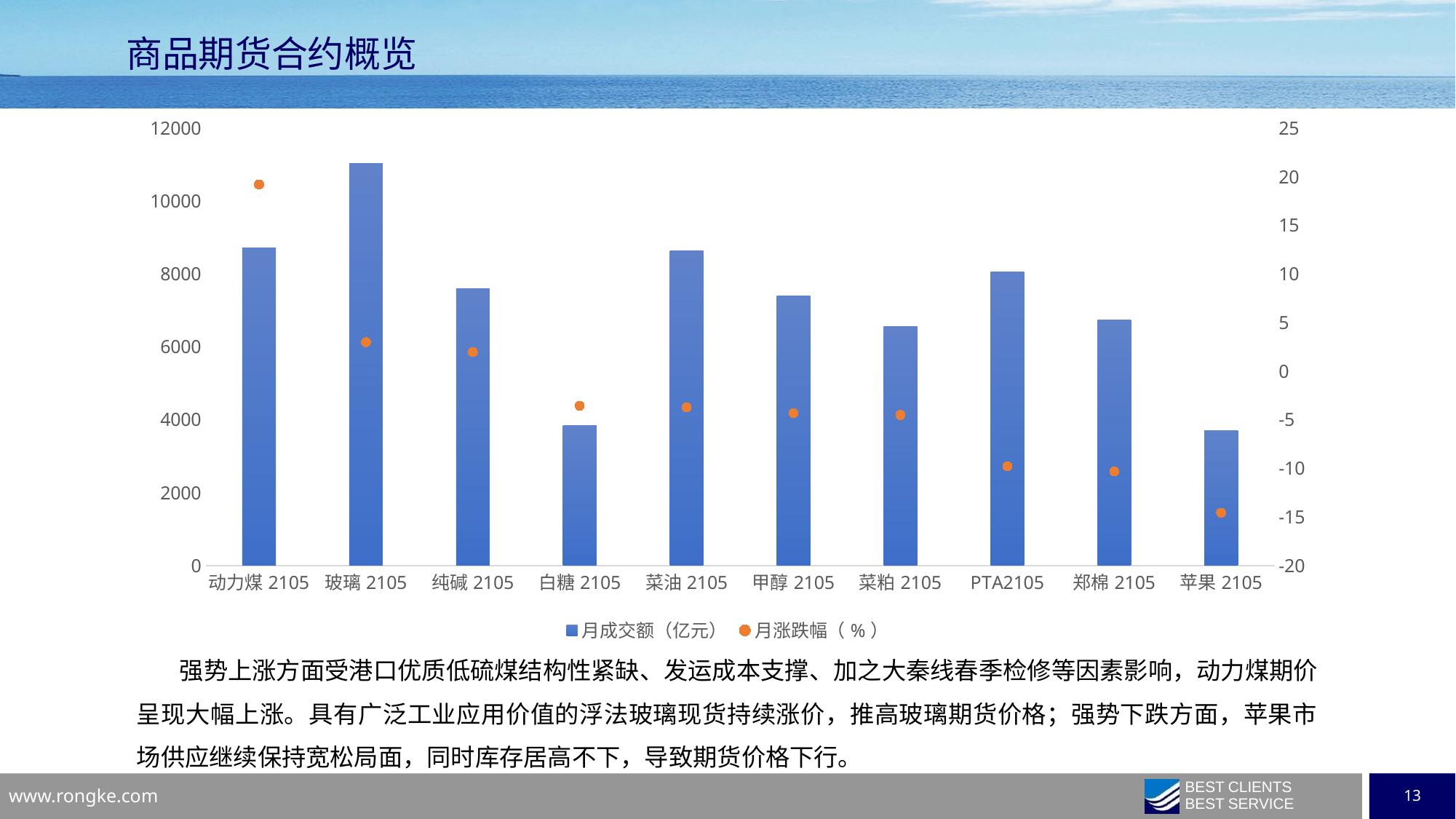
What kind of chart is shown on the slide? Bar chart with dot markers (combo chart) Which contract has the highest 月涨跌幅（%） marker? 动力煤 2105 Is the 月涨跌幅（%） marker for 动力煤 2105 greater or less than 15? greater Is the 月成交额（亿元） bar for 玻璃 2105 greater or less than 10000? greater Is the 月成交额（亿元） bar for 白糖 2105 greater or less than 4000? less Which has the larger 月成交额（亿元） bar, 动力煤 2105 or 纯碱 2105? 动力煤 2105 Which contract has the lowest 月涨跌幅（%） marker? 苹果 2105 What is the title of the chart on the slide? 商品期货合约概览 Which contract has the highest 月成交额（亿元） bar? 玻璃 2105 What are the two series named in the chart legend? 月成交额（亿元） and 月涨跌幅（%） How many series does the chart legend list? 2 How many categories (contracts) are shown on the x axis of the chart? 10